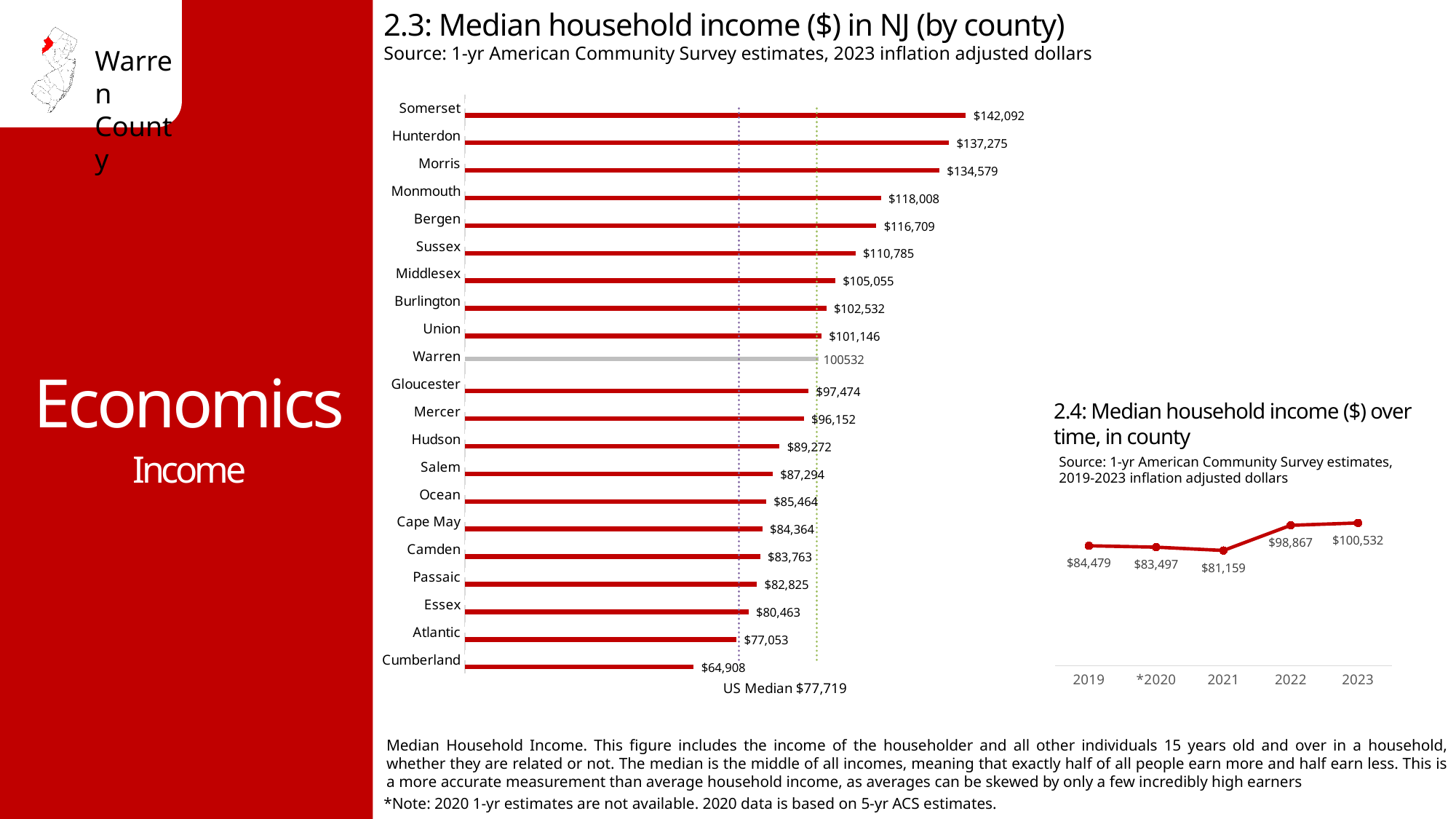
In the chart '2.3: Median household income ($) in NJ (by county)', what value is shown for Warren? 100532 In the chart '2.4: Median household income ($) over time, in county', which year has the highest median household income? 2023 In the chart '2.3: Median household income ($) in NJ (by county)', which county has the lowest median household income? Cumberland What type of chart is '2.3: Median household income ($) in NJ (by county)'? Bar chart In the chart '2.3: Median household income ($) in NJ (by county)', what is the difference between Somerset's and Cumberland's median household income? $77,184 In the chart '2.3: Median household income ($) in NJ (by county)', what is the median household income for Somerset? $142,092 In the chart '2.4: Median household income ($) over time, in county', what is the difference between the 2023 and 2019 values? $16,053 In the chart '2.3: Median household income ($) in NJ (by county)', which has a higher median household income, Bergen or Sussex? Bergen In the chart '2.3: Median household income ($) in NJ (by county)', what US Median value is noted below the chart? $77,719 How many counties are shown in the chart '2.3: Median household income ($) in NJ (by county)'? 21 In the chart '2.3: Median household income ($) in NJ (by county)', which county has the highest median household income? Somerset In the chart '2.4: Median household income ($) over time, in county', what is the value for 2021? $81,159